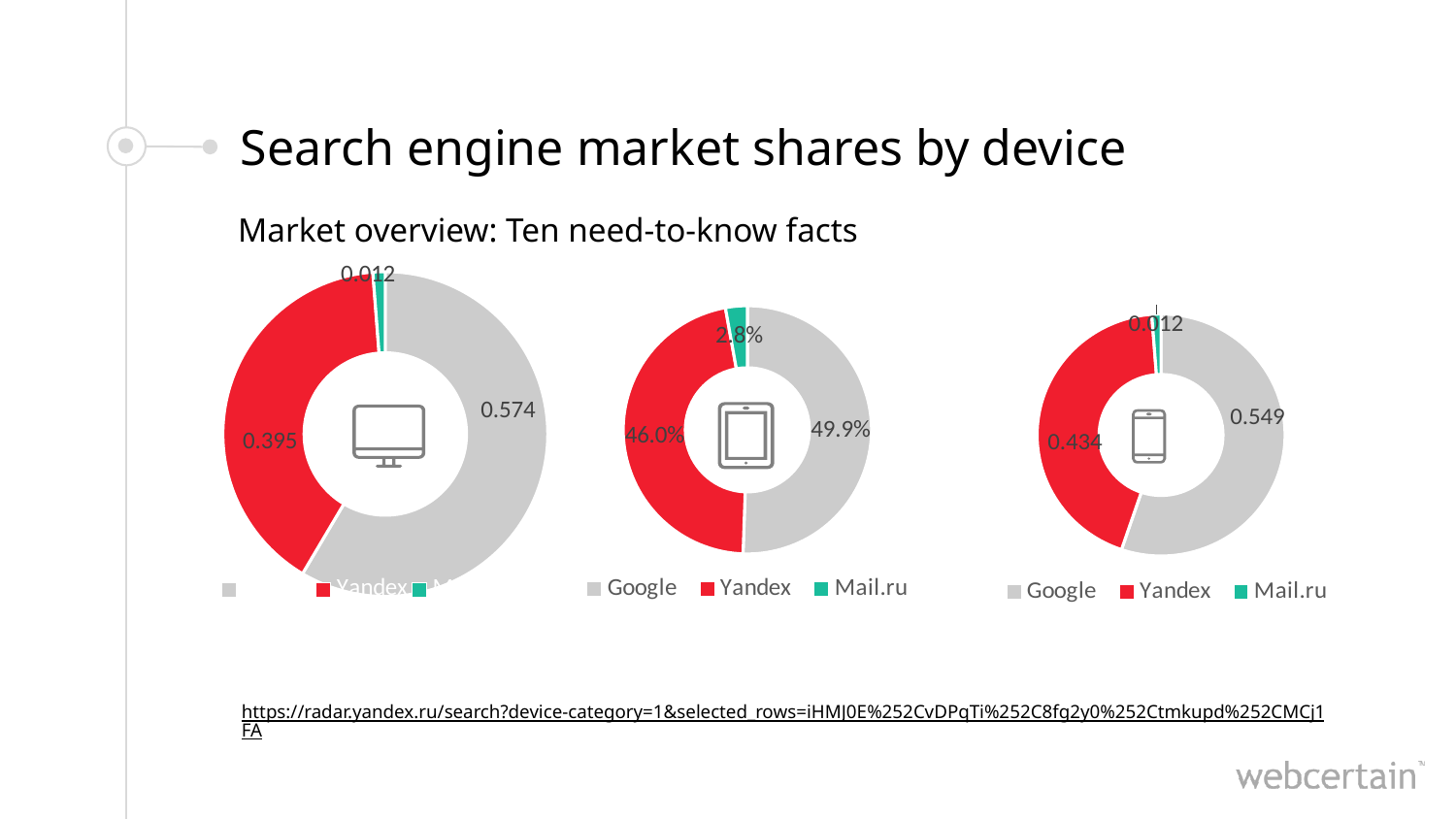
In the left doughnut chart (desktop icon), what is the value shown for the grey Google slice? 0.574 In the middle doughnut chart (tablet icon), by how many percentage points does Google exceed Yandex? 3.9% In the right doughnut chart (phone icon), what is the value shown for Google? 0.549 What type of chart is used for each of the three charts on the slide? Doughnut (pie) chart In the middle doughnut chart (tablet icon), which search engine has the largest share? Google In the right doughnut chart (phone icon), what is the value shown for Yandex? 0.434 In the middle doughnut chart (tablet icon), what is the value shown for Yandex? 46.0% In the middle doughnut chart (tablet icon), what is the value shown for Mail.ru? 2.8% In the left doughnut chart (desktop icon), what is the value shown for the red Yandex slice? 0.395 How many search engines does the legend of the right doughnut chart list? 3 In the left doughnut chart (desktop icon), what is the difference between the Google value and the Yandex value? 0.179 In the right doughnut chart (phone icon), which search engine has the smallest share? Mail.ru